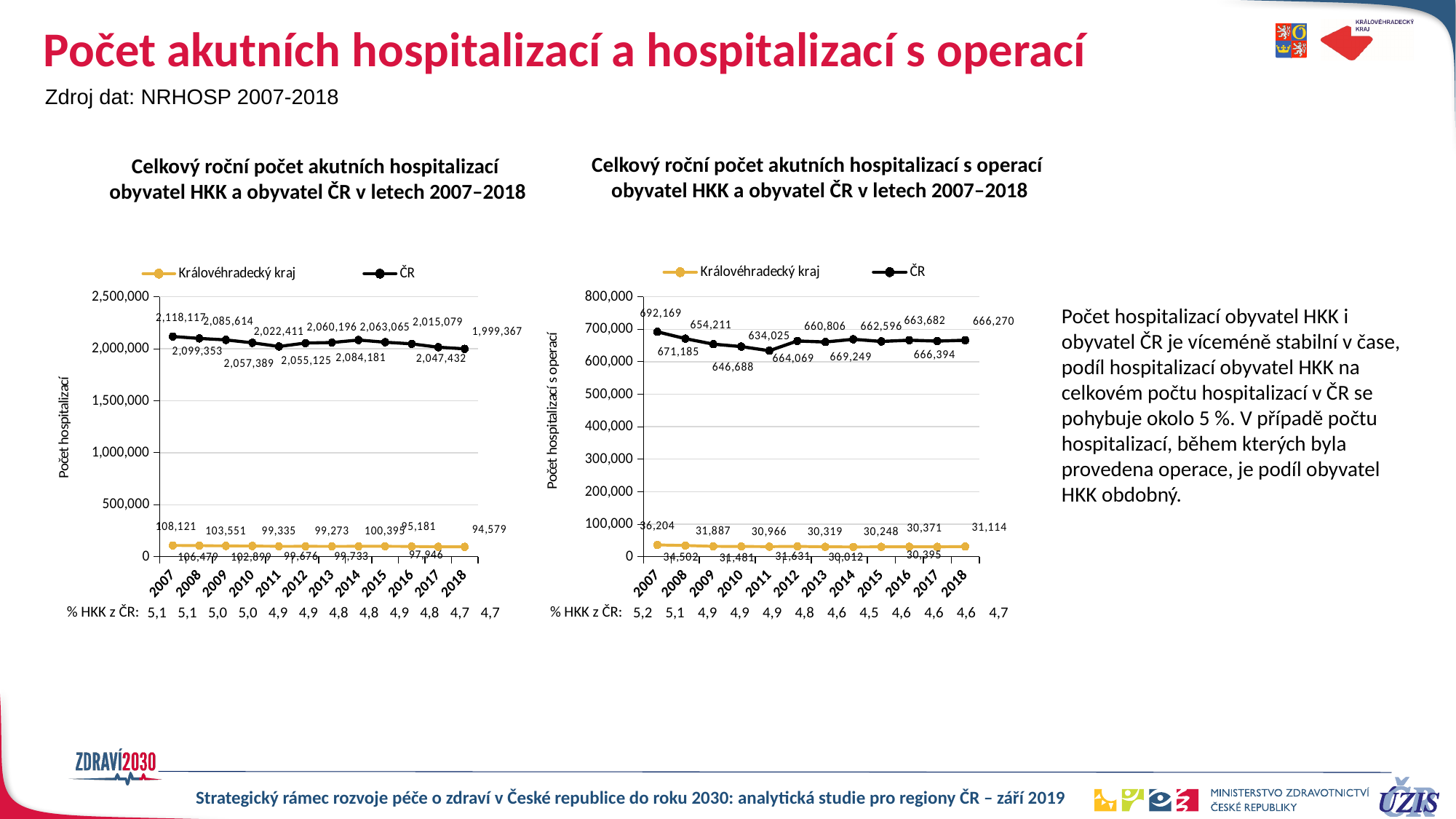
In the left chart (Celkový roční počet akutních hospitalizací), which year has the highest value for ČR? 2007 In the right chart (hospitalizací s operací), what is the difference between the Královéhradecký kraj values in 2007 and 2018? 5,090 In the right chart (hospitalizací s operací), what is the value for ČR in 2011? 634,025 In the right chart (hospitalizací s operací), what is the value for Královéhradecký kraj in 2007? 36,204 In the right chart (hospitalizací s operací), which year has the lowest value for ČR? 2011 In the right chart (hospitalizací s operací), is the ČR value in 2014 larger or smaller than in 2015? larger How many years are plotted on the x axis of the right chart? 12 In the left chart (Celkový roční počet akutních hospitalizací), what is the difference between the ČR values in 2007 and 2018? 118,750 In the left chart (Celkový roční počet akutních hospitalizací), what is the value for ČR in 2007? 2,118,117 What kind of chart is the left chart (Celkový roční počet akutních hospitalizací)? line chart How many series does the legend of the left chart list? 2 In the left chart (Celkový roční počet akutních hospitalizací), what is the value for Královéhradecký kraj in 2018? 94,579